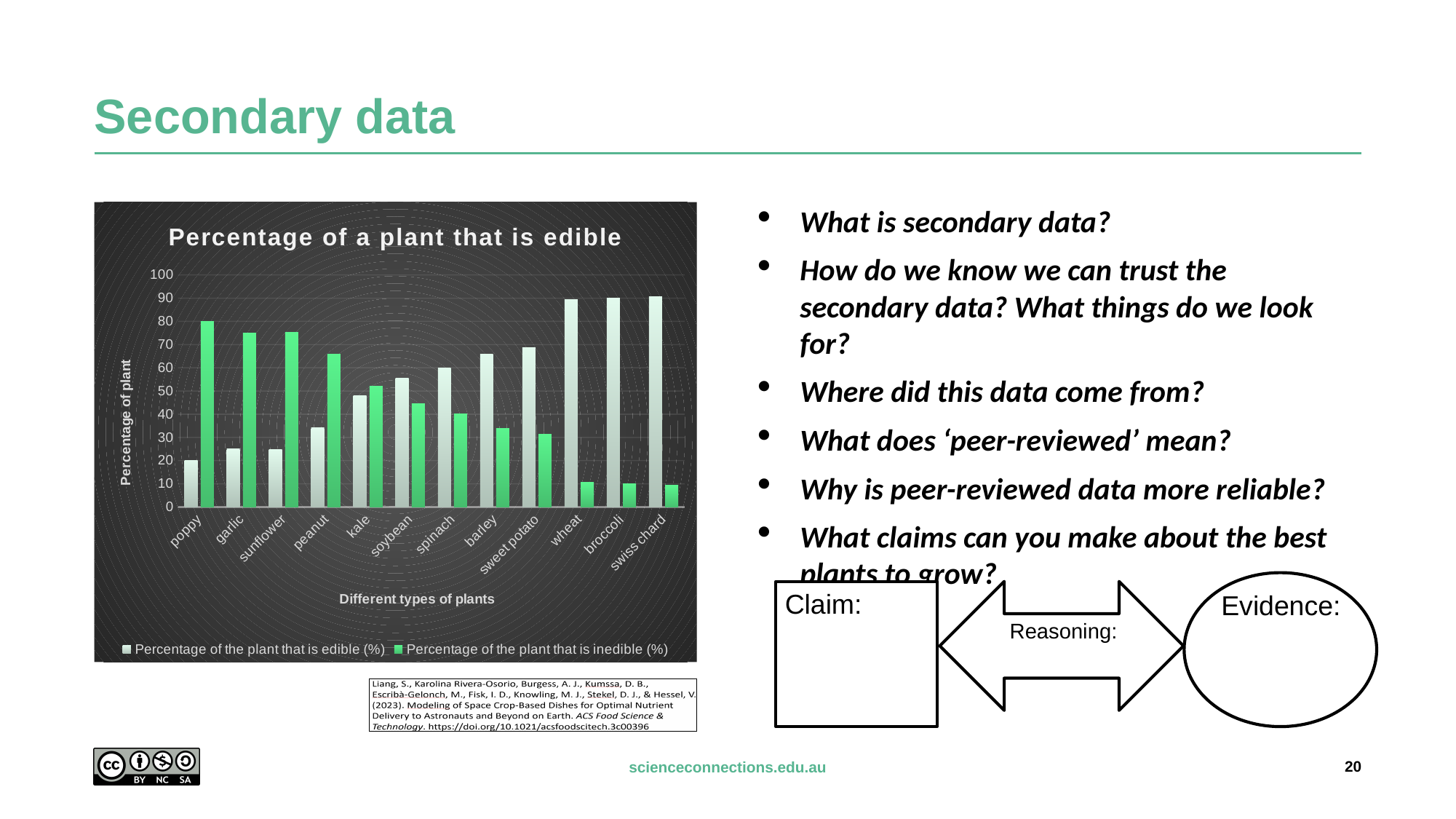
Is the percentage of the plant that is edible for poppy greater or less than 30? less Is the percentage of the plant that is inedible for sweet potato greater or less than 40? less What is the title of the chart? Percentage of a plant that is edible Is the percentage of the plant that is inedible for peanut greater or less than 60? greater How many series does the legend list? 2 Do the percentages of the plant that is edible generally rise or fall from poppy to swiss chard along the x axis? rise Which plant has the highest percentage of the plant that is inedible? poppy Which plant has the lowest percentage of the plant that is edible? poppy What kind of chart is shown on the slide? bar chart For soybean, which is larger: the percentage that is edible or the percentage that is inedible? edible How many types of plants are shown on the x axis? 12